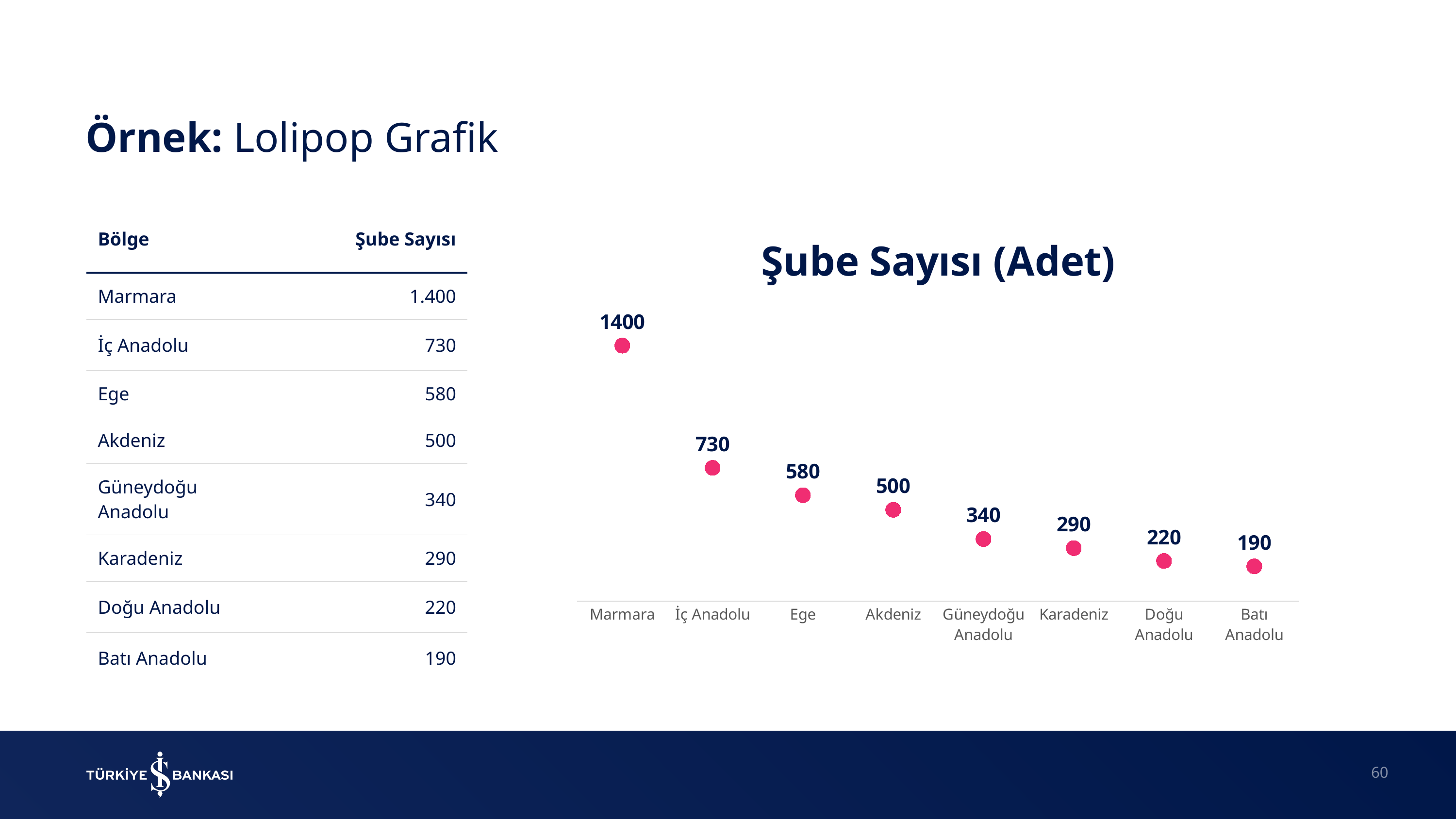
What is the value for Marmara in the chart? 1400 Which region has the lowest value in the chart? Batı Anadolu What is the value for Güneydoğu Anadolu in the chart? 340 Do the values rise or fall from left to right along the x axis? fall What is the difference between the values for İç Anadolu and Ege? 150 How many regions are plotted in the chart? 8 What is the title of the chart? Şube Sayısı (Adet) What colour are the data points in the chart? pink Which region has the highest value in the chart? Marmara What is the difference between the values for Marmara and Batı Anadolu? 1210 What is the value for Karadeniz in the chart? 290 Which has a larger value, Akdeniz or Doğu Anadolu? Akdeniz